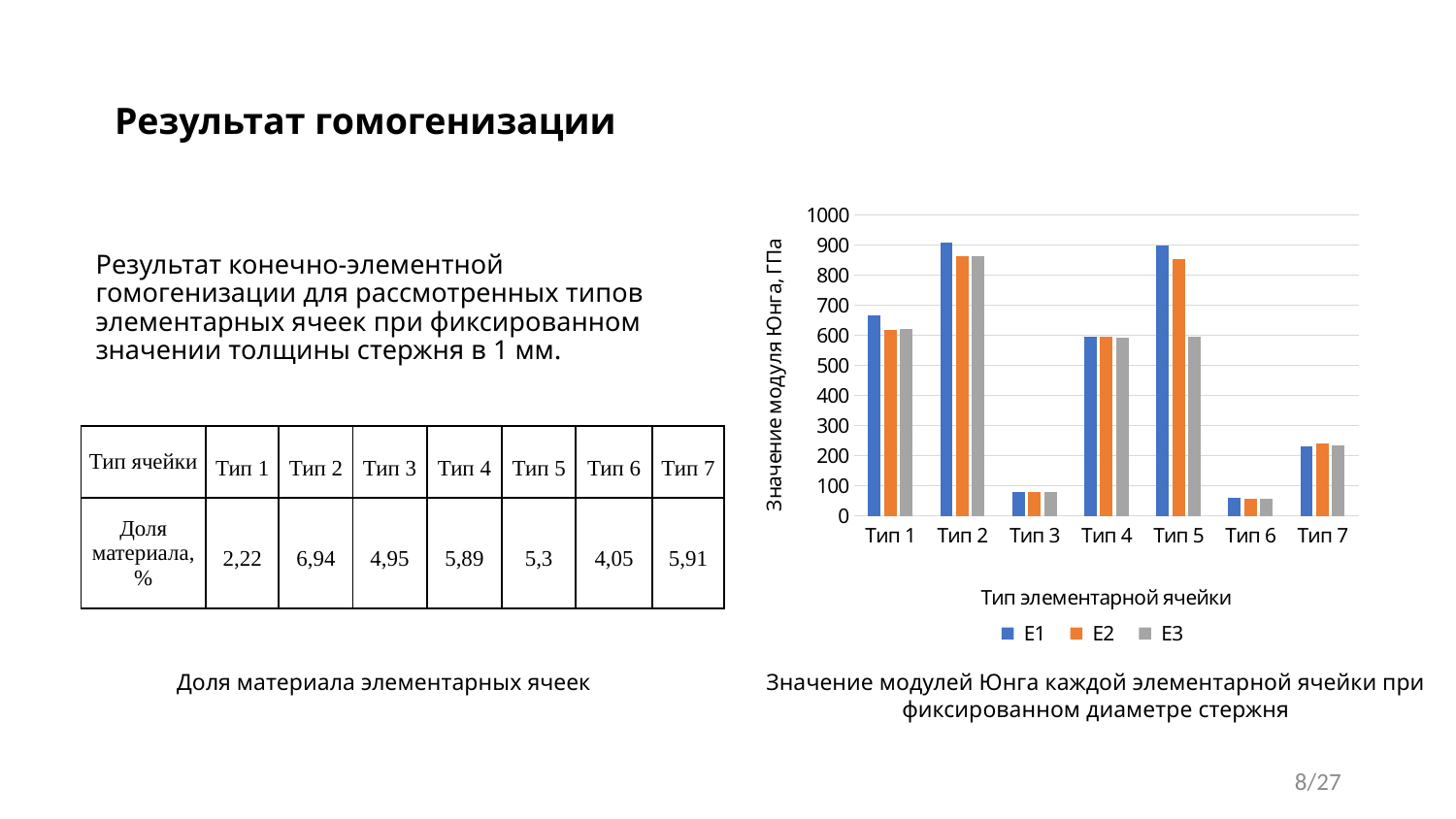
What kind of chart is shown on the slide? bar chart Is the E3 value for Тип 5 greater or less than 700? less For Тип 1, which is larger: E1 or E2? E1 Is the E2 value for Тип 7 greater or less than 300? less Which cell type has the highest E3 value? Тип 2 What is the y-axis title of the chart? Значение модуля Юнга, ГПа Is the E1 value for Тип 2 greater or less than 800? greater Which cell type has the lowest E1 value? Тип 6 For Тип 5, which is larger: E1 or E3? E1 How many cell types are shown on the x axis of the chart? 7 How many series does the chart legend list? 3